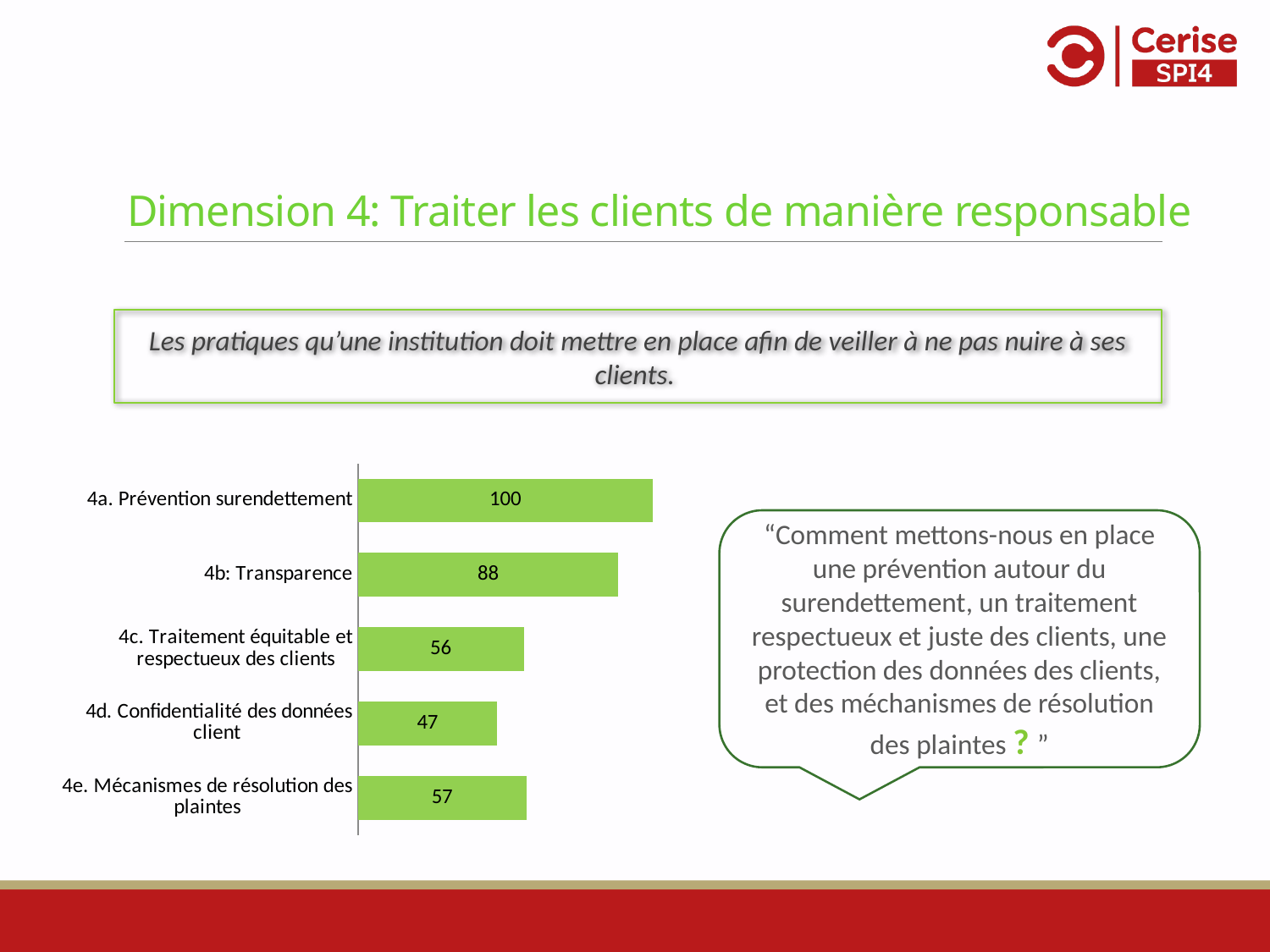
What is the value for 4a. Prévention surendettement? 100 Which category has the highest value? 4a. Prévention surendettement What is the value for 4b: Transparence? 88 Which is larger, the value for 4c. Traitement équitable et respectueux des clients or the value for 4b: Transparence? 4b: Transparence What colour are the bars in the chart? Green How many categories are shown in the chart? 5 Which category has the lowest value? 4d. Confidentialité des données client What is the difference between the values for 4a. Prévention surendettement and 4b: Transparence? 12 What kind of chart is shown on the slide? Bar chart What is the value for 4d. Confidentialité des données client? 47 What is the difference between the values for 4e. Mécanismes de résolution des plaintes and 4d. Confidentialité des données client? 10 What is the value for 4e. Mécanismes de résolution des plaintes? 57